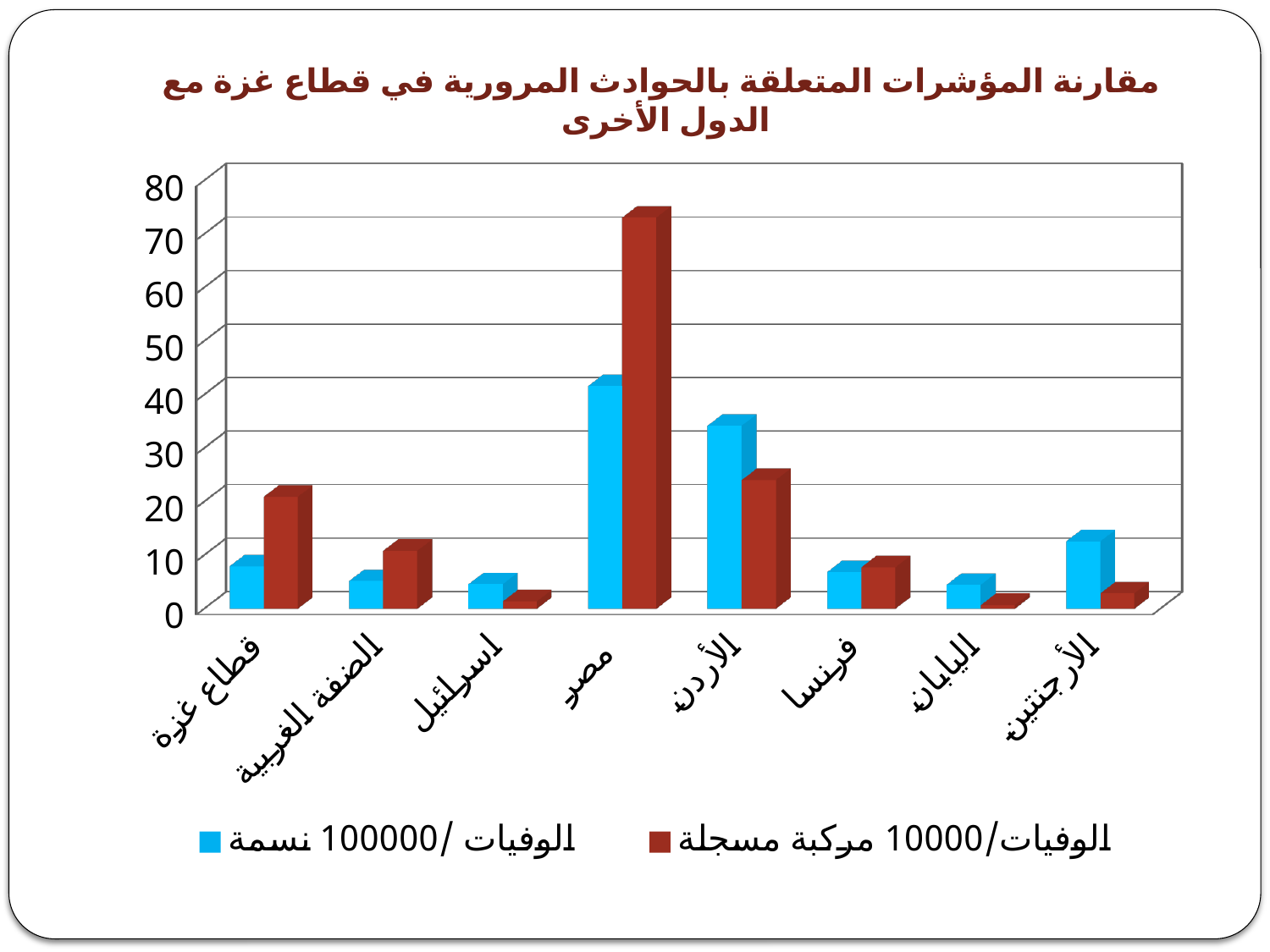
For قطاع غزة, which series has the larger value: الوفيات/10000 مركبة مسجلة or الوفيات/100000 نسمة? الوفيات/10000 مركبة مسجلة Which colour represents the series الوفيات/10000 مركبة مسجلة in the legend? Red What kind of chart is shown on the slide? Bar chart Is the value of الوفيات/10000 مركبة مسجلة for قطاع غزة greater or less than 10? greater For الأردن, which series has the larger value: الوفيات/10000 مركبة مسجلة or الوفيات/100000 نسمة? الوفيات/100000 نسمة Is the value of الوفيات/100000 نسمة for الأردن greater or less than 30? greater How many series does the legend list? 2 How many countries/regions are shown on the x axis of the chart? 8 Is the value of الوفيات/10000 مركبة مسجلة for مصر greater or less than 60? greater Which category has the highest value for الوفيات/10000 مركبة مسجلة? مصر Which category has the highest value for الوفيات/100000 نسمة? مصر